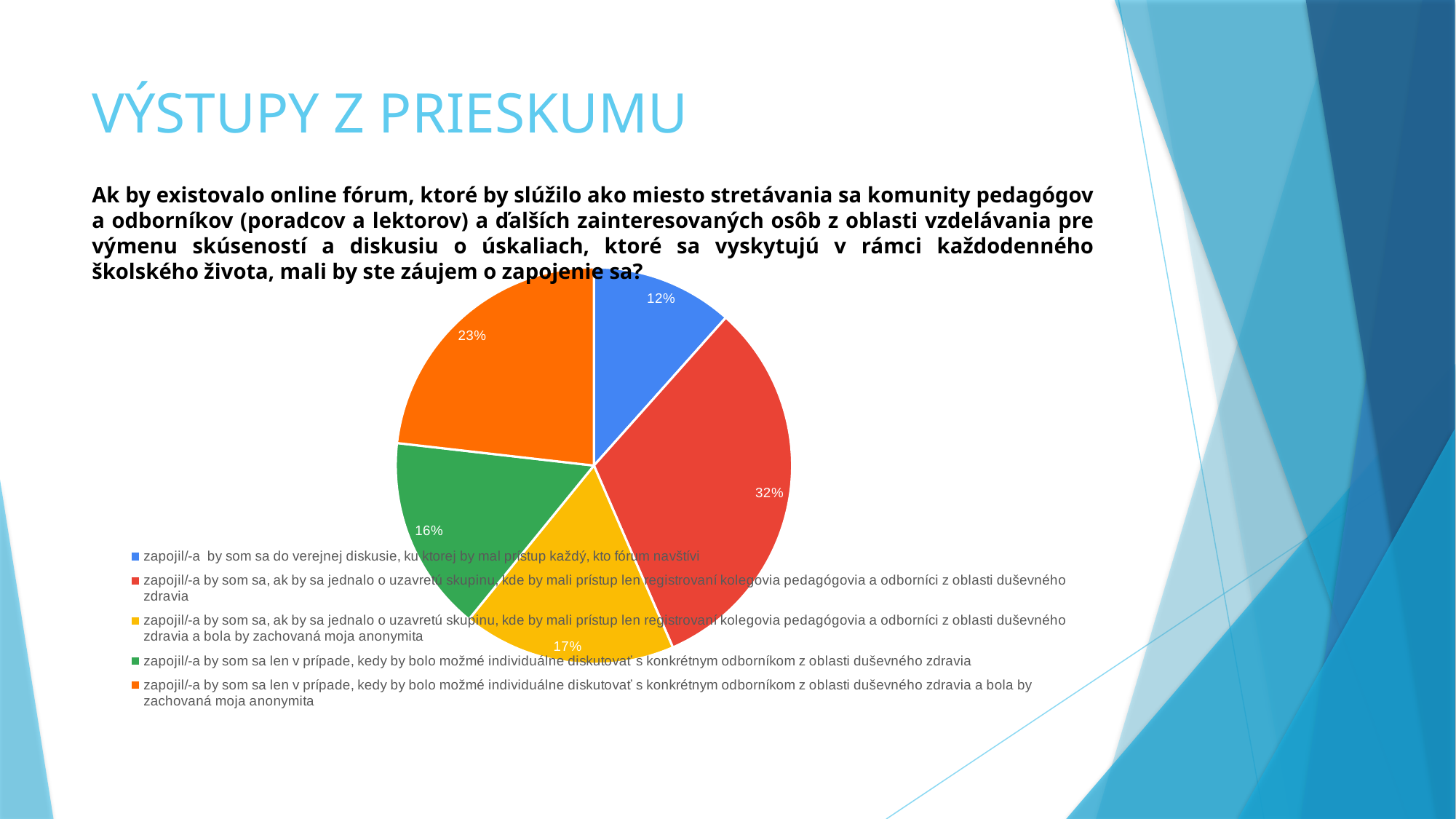
What percentage is shown for the yellow slice (uzavretá skupina, kde by bola zachovaná moja anonymita)? 17% What percentage is shown for the red slice (uzavretá skupina s registrovanými kolegami pedagógmi a odborníkmi, bez anonymity)? 32% What percentage is shown for the orange slice (individuálne diskutovať s konkrétnym odborníkom a bola by zachovaná moja anonymita)? 23% How many entries does the legend of the pie chart list? 5 What percentage is shown for the green slice (individuálne diskutovať s konkrétnym odborníkom z oblasti duševného zdravia, bez anonymity)? 16% What percentage is shown for the blue slice (zapojil/-a by som sa do verejnej diskusie, ku ktorej by mal prístup každý, kto fórum navštívi)? 12% How many slices does the pie chart have? 5 Which slice of the pie chart is the largest? the red slice (uzavretá skupina s registrovanými kolegami pedagógmi a odborníkmi), 32% What kind of chart is shown on the slide? pie chart What is the difference in percentage points between the red slice (32%) and the orange slice (23%)? 9 percentage points Which slice of the pie chart is the smallest? the blue slice (verejná diskusia, ku ktorej by mal prístup každý), 12% Which is larger: the orange slice or the green slice? the orange slice (23%)